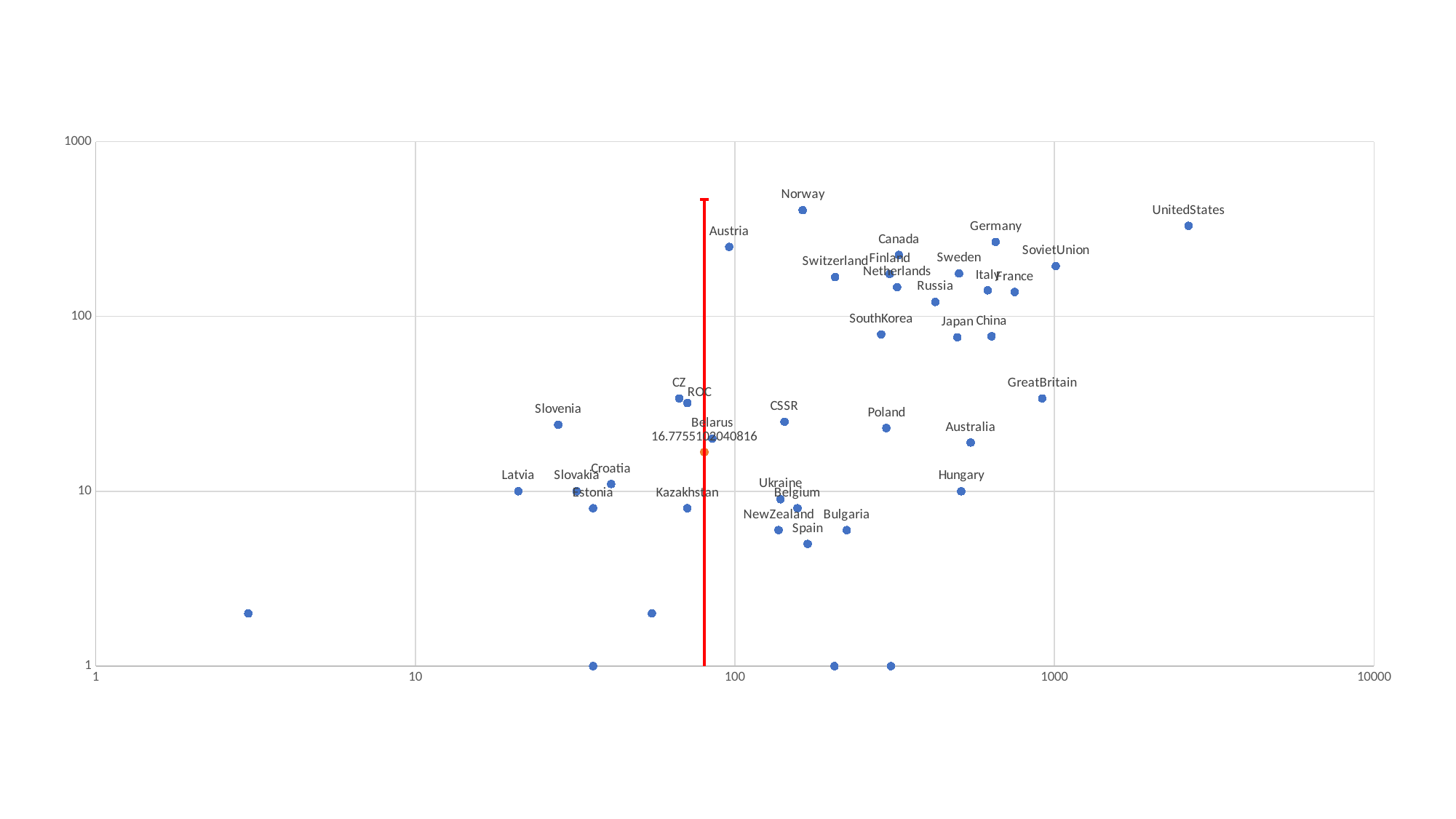
What colour is the vertical line drawn on the chart? red What value is printed next to the orange point? 16.7755102040816 Which labeled point has the highest vertical-axis value? Norway Is the horizontal-axis value for UnitedStates greater or less than 1000? greater Is the vertical-axis value for Switzerland greater or less than 100? greater Which labeled point has the highest horizontal-axis value? UnitedStates What kind of chart is shown on the slide? scatter chart Which has the higher vertical-axis value, Slovenia or Croatia? Slovenia Which labeled point has the lowest vertical-axis value? Spain Which has the higher vertical-axis value, Norway or Austria? Norway Which labeled point is furthest left on the horizontal axis? Latvia Is the vertical-axis value for Kazakhstan greater or less than 10? less